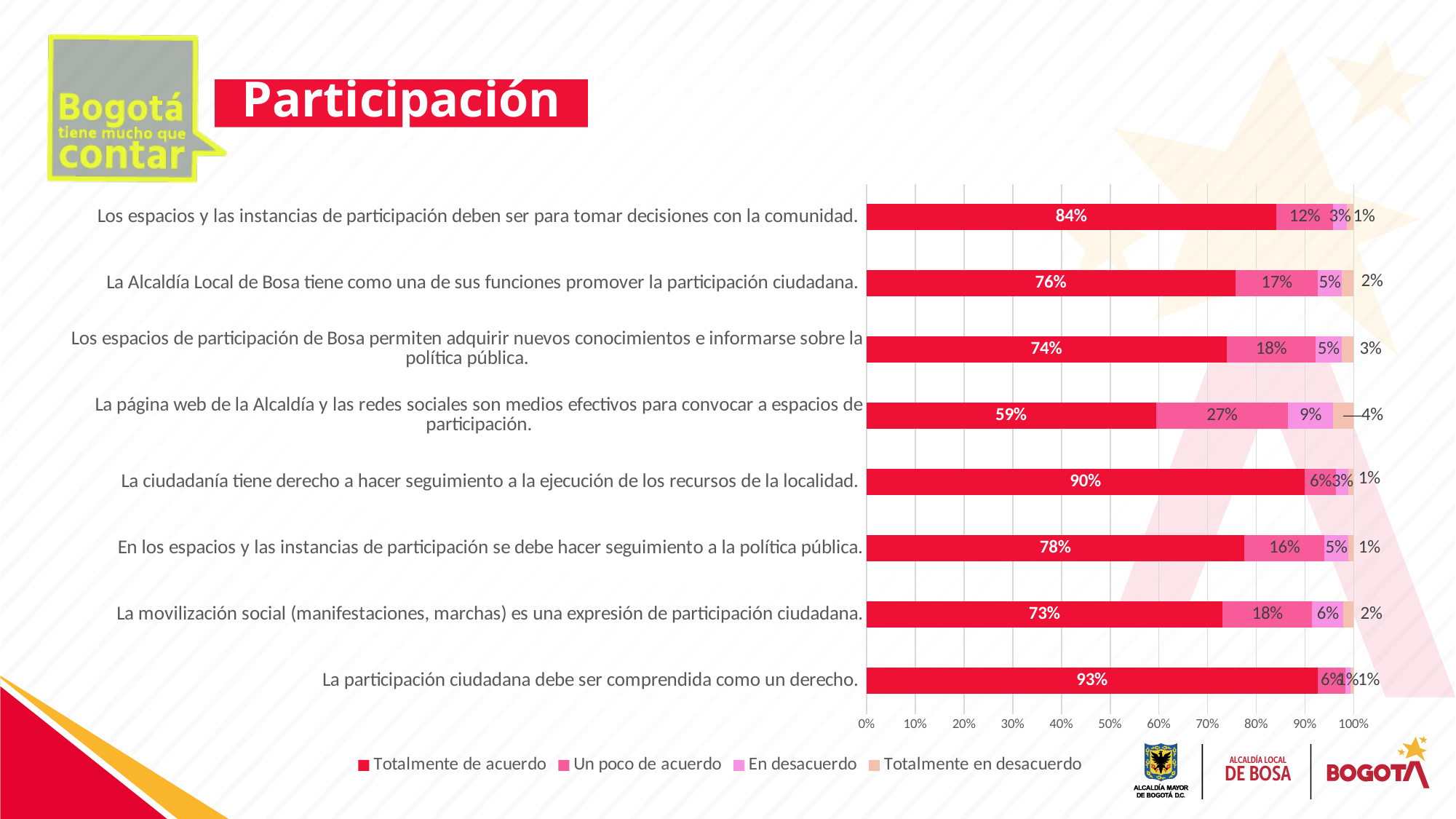
What is the "En desacuerdo" value for "La movilización social (manifestaciones, marchas) es una expresión de participación ciudadana"? 6% Which statement has the highest "Totalmente de acuerdo" percentage? La participación ciudadana debe ser comprendida como un derecho. Which legend entry is shown in the lightest (peach) colour? Totalmente en desacuerdo Which has a larger "Un poco de acuerdo" value: "La Alcaldía Local de Bosa tiene como una de sus funciones promover la participación ciudadana" or "En los espacios y las instancias de participación se debe hacer seguimiento a la política pública"? La Alcaldía Local de Bosa tiene como una de sus funciones promover la participación ciudadana. What is the "Un poco de acuerdo" value for "La página web de la Alcaldía y las redes sociales son medios efectivos para convocar a espacios de participación"? 27% What kind of chart is shown on the slide? Stacked bar chart What is the "Totalmente en desacuerdo" value for "Los espacios de participación de Bosa permiten adquirir nuevos conocimientos e informarse sobre la política pública"? 3% What is the difference between the "Totalmente de acuerdo" values for "La ciudadanía tiene derecho a hacer seguimiento a la ejecución de los recursos de la localidad" and "La Alcaldía Local de Bosa tiene como una de sus funciones promover la participación ciudadana"? 14% How many statements (categories) are shown in the chart? 8 What percentage of respondents are "Totalmente de acuerdo" that "La participación ciudadana debe ser comprendida como un derecho"? 93% Which statement has the lowest "Totalmente de acuerdo" percentage? La página web de la Alcaldía y las redes sociales son medios efectivos para convocar a espacios de participación. How many series does the legend list? 4